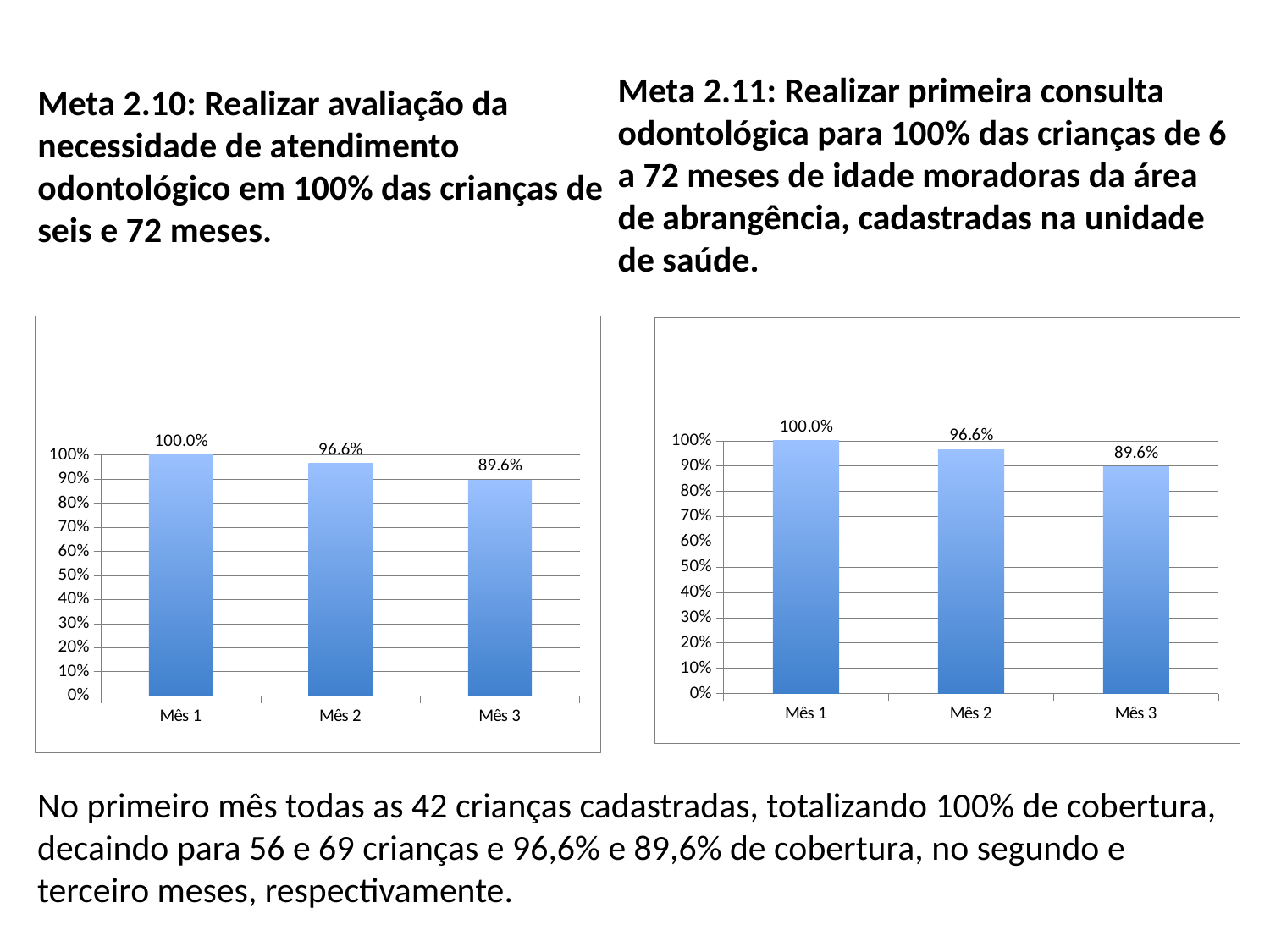
In the left chart, which month has the lowest value? Mês 3 In the right chart, which month has the highest value? Mês 1 In the left chart, what is the difference between the values for Mês 2 and Mês 3? 7.0% In the right chart, what is the value for Mês 3? 89.6% In the left chart, which is larger, the value for Mês 2 or the value for Mês 3? Mês 2 How many categories are shown on the x axis of the right chart? 3 What kind of chart is the left chart? bar chart In the left chart, what is the value for Mês 2? 96.6% In the right chart, is the value for Mês 3 greater or less than 90%? less In the right chart, do the values rise or fall from Mês 1 to Mês 3? fall In the left chart, what is the value for Mês 1? 100.0% In the right chart, what is the difference between the values for Mês 1 and Mês 3? 10.4%